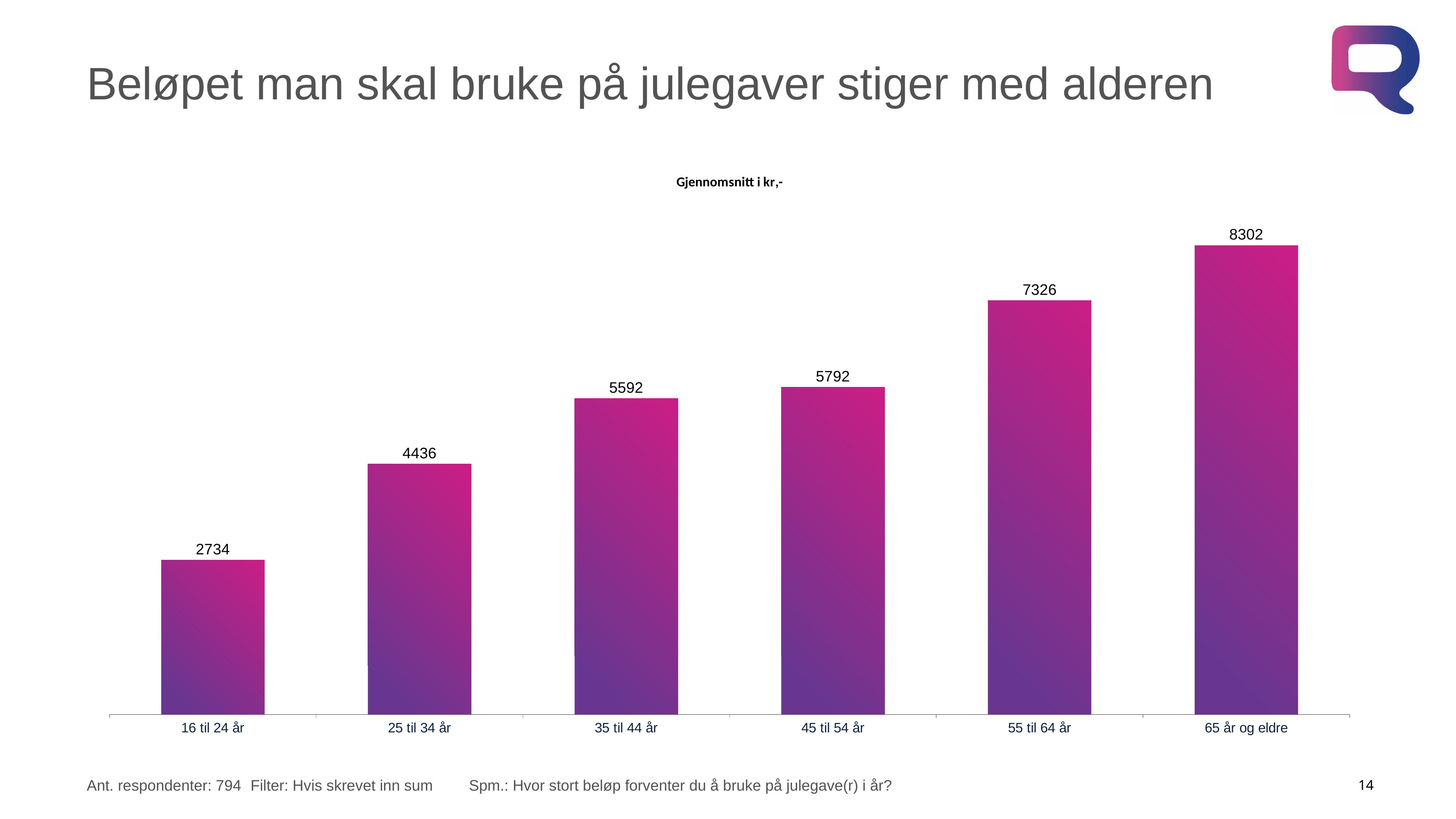
How many age groups are shown in the chart? 6 Which age group has the highest value? 65 år og eldre What is the value for 45 til 54 år? 5792 What is the value for 65 år og eldre? 8302 What kind of chart is shown on the slide? bar chart Do the values rise or fall from the youngest to the oldest age group? rise Which age group has the lowest value? 16 til 24 år What is the difference between the values for 65 år og eldre and 16 til 24 år? 5568 What is the title of the chart? Gjennomsnitt i kr,- What is the difference between the values for 55 til 64 år and 25 til 34 år? 2890 Which is larger, the value for 35 til 44 år or the value for 55 til 64 år? 55 til 64 år What is the value for 16 til 24 år? 2734